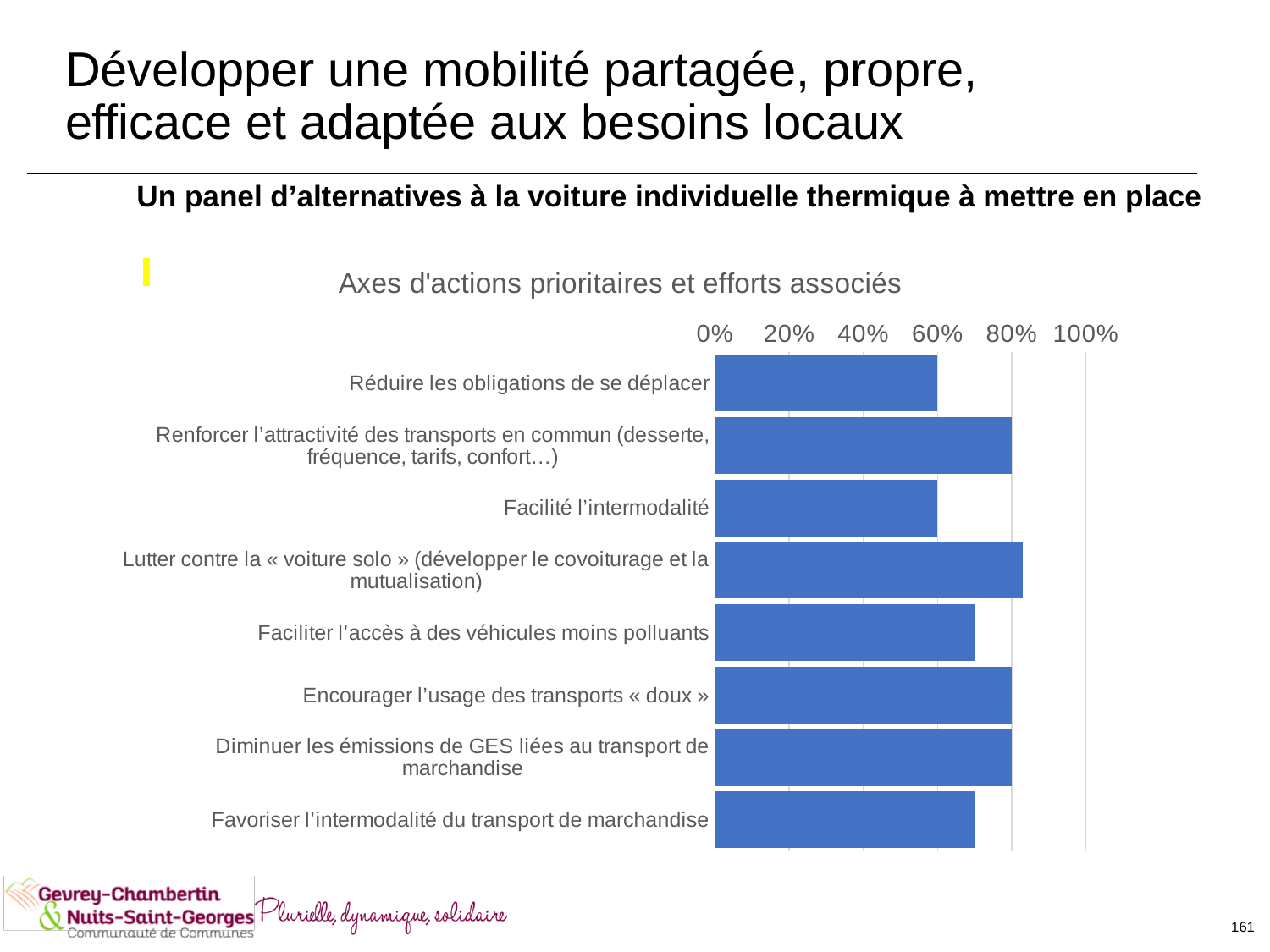
Is the value for "Favoriser l'intermodalité du transport de marchandise" greater or less than 80%? less What is the maximum value shown on the chart's percentage axis? 100% Which is larger: the value for "Lutter contre la « voiture solo »" or the value for "Faciliter l'accès à des véhicules moins polluants"? Lutter contre la « voiture solo » Is the value for "Réduire les obligations de se déplacer" greater or less than 80%? less Is the value for "Lutter contre la « voiture solo »" greater or less than 80%? greater What is the title of the chart? Axes d'actions prioritaires et efforts associés Which is larger: the value for "Encourager l'usage des transports « doux »" or the value for "Réduire les obligations de se déplacer"? Encourager l'usage des transports « doux » How many categories (action axes) are plotted in the chart? 8 What kind of chart is shown on the slide? bar chart Which category has the highest value in the chart? Lutter contre la « voiture solo » (développer le covoiturage et la mutualisation)